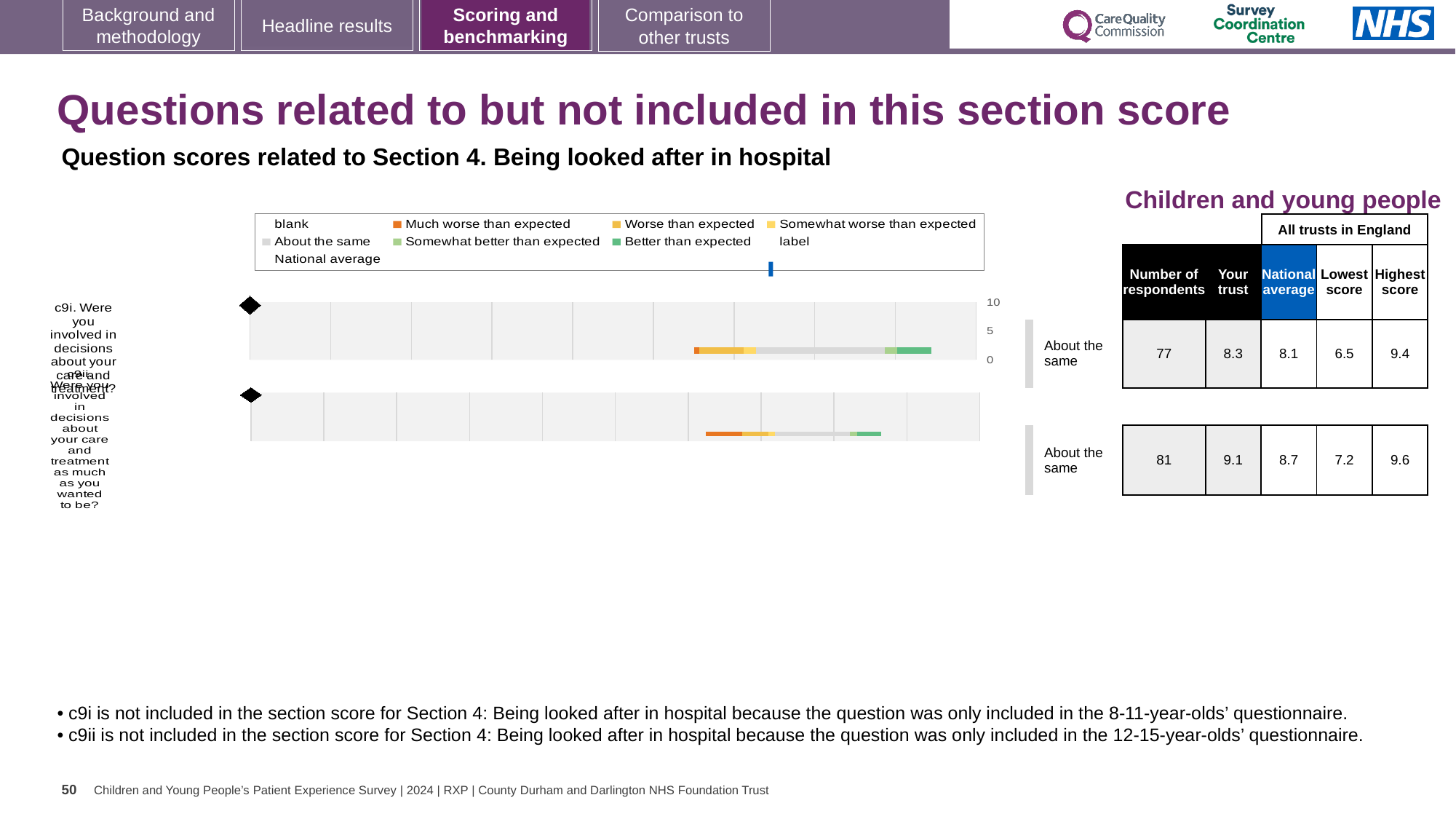
What is the 'Your trust' score for question c9i? 8.3 Which question has more respondents, c9i or c9ii? c9ii How many questions are plotted in the chart? 2 What benchmark category is shown next to the bar for question c9ii? About the same For question c9i, which is higher: the 'Your trust' score or the national average? Your trust By how much does the 'Your trust' score for c9i exceed the national average? 0.2 What kind of chart is used to show the question scores for c9i and c9ii? Bar chart How many respondents answered question c9i? 77 What is the national average score for question c9ii? 8.7 What is the difference between the highest and lowest scores for question c9ii? 2.4 What is the highest score among all trusts in England for question c9ii? 9.6 What is the lowest score among all trusts in England for question c9i? 6.5